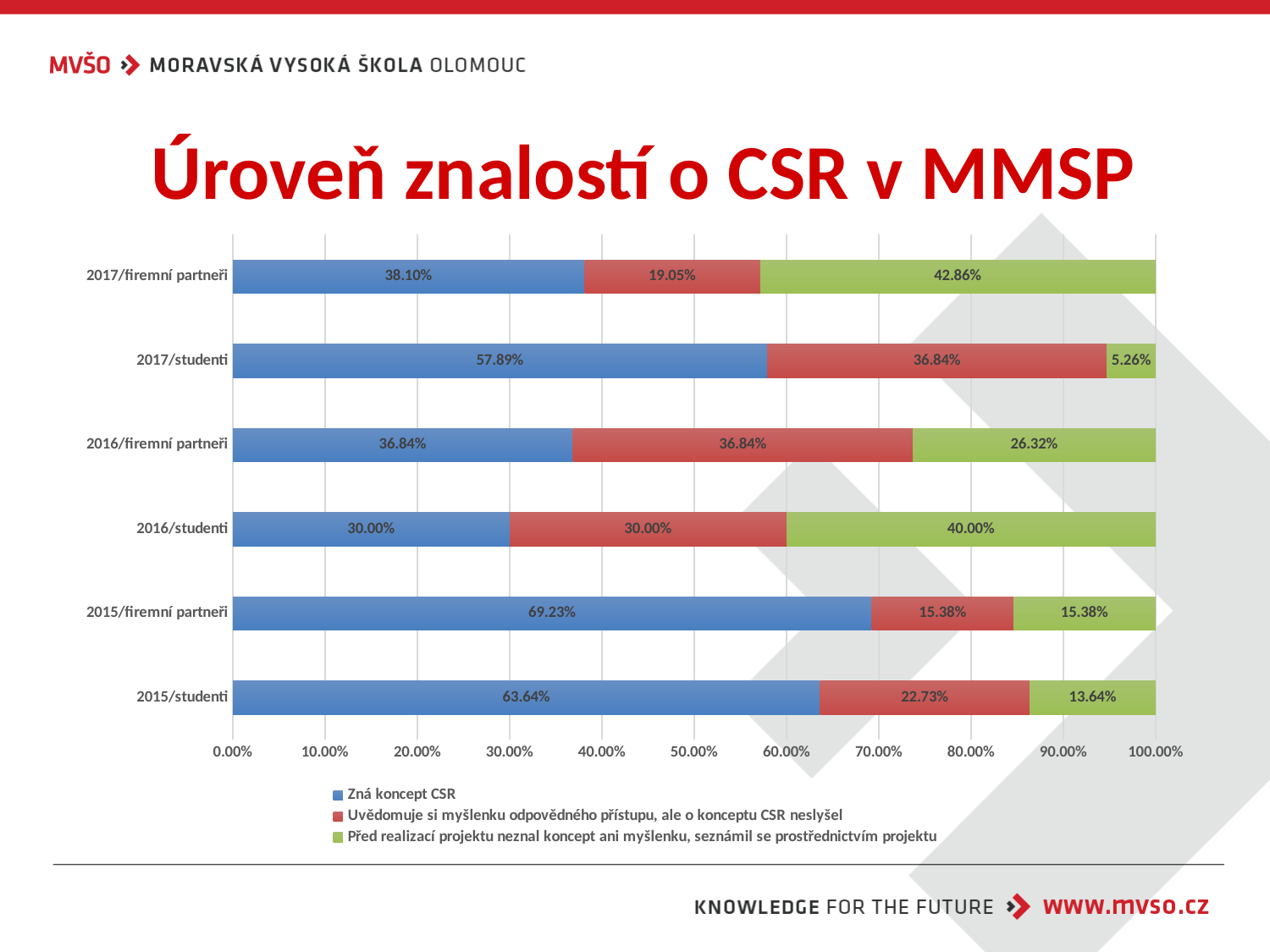
What is the total of the stacked bar for 2016/studenti? 100.00% Which category has the lowest value for 'Před realizací projektu neznal koncept ani myšlenku, seznámil se prostřednictvím projektu'? 2017/studenti Which is larger: the 'Zná koncept CSR' value for 2016/studenti or for 2016/firemní partneři? 2016/firemní partneři What is the value of 'Zná koncept CSR' for 2017/studenti? 57.89% What is the value of 'Před realizací projektu neznal koncept ani myšlenku, seznámil se prostřednictvím projektu' for 2017/firemní partneři? 42.86% How many series does the legend list? 3 Which category has the highest value for 'Zná koncept CSR'? 2015/firemní partneři What kind of chart is shown on the slide? Stacked bar chart What is the title of the slide containing the chart? Úroveň znalostí o CSR v MMSP What is the difference between the 'Zná koncept CSR' values for 2015/firemní partneři and 2015/studenti? 5.59% How many categories are shown on the vertical axis of the chart? 6 What is the value of 'Uvědomuje si myšlenku odpovědného přístupu, ale o konceptu CSR neslyšel' for 2015/studenti? 22.73%